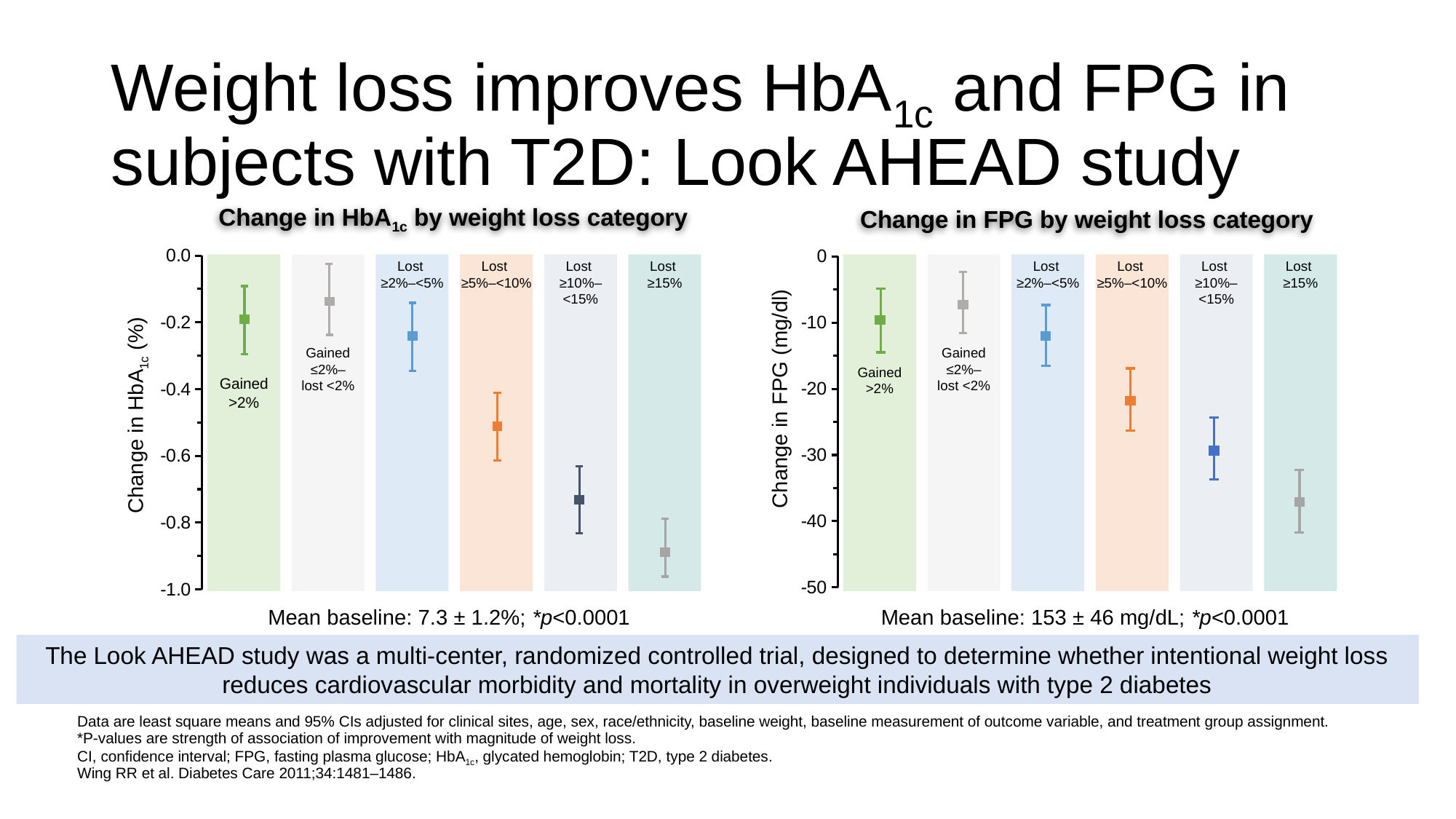
In the 'Change in HbA1c by weight loss category' chart, which category has the lowest (most negative) value? Lost ≥15% What is the y-axis label of the 'Change in FPG by weight loss category' chart? Change in FPG (mg/dl) What kind of chart is the 'Change in HbA1c by weight loss category' chart? Scatter chart with error bars In the 'Change in FPG by weight loss category' chart, is the value for Lost ≥15% greater or less than -40? greater In the 'Change in FPG by weight loss category' chart, which category has the lowest (most negative) value? Lost ≥15% In the 'Change in FPG by weight loss category' chart, is the value for Lost ≥5%–<10% greater or less than -30? greater In the 'Change in FPG by weight loss category' chart, how many weight loss categories are plotted? 6 In the 'Change in HbA1c by weight loss category' chart, is the value for Lost ≥5%–<10% greater or less than -0.6? greater In the 'Change in FPG by weight loss category' chart, which has the lower value: Lost ≥5%–<10% or Lost ≥10%–<15%? Lost ≥10%–<15% In the 'Change in HbA1c by weight loss category' chart, how many weight loss categories are plotted? 6 In the 'Change in HbA1c by weight loss category' chart, do the values rise or fall from Lost ≥2%–<5% to Lost ≥15%? fall